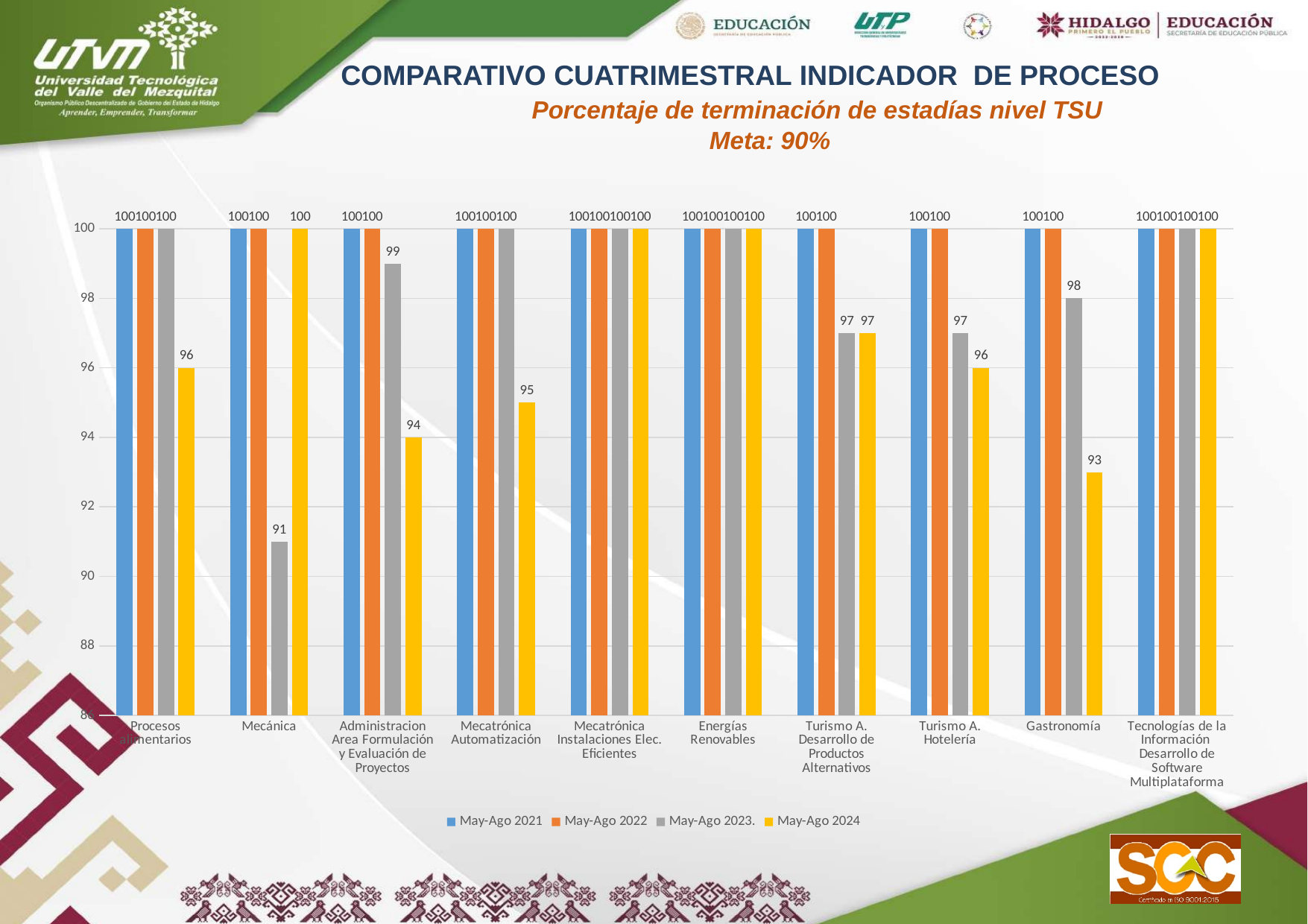
Which category has the lowest May-Ago 2024 value? Gastronomía Which category has the lowest May-Ago 2023 value? Mecánica How many categories (programs) are shown on the x axis? 10 Which is larger for Turismo A. Hotelería: the May-Ago 2023 value or the May-Ago 2024 value? May-Ago 2023 What target (Meta) is stated in the chart's subtitle? 90% What is the May-Ago 2024 value for Gastronomía? 93 What is the May-Ago 2024 value for Procesos alimentarios? 96 What is the difference between the May-Ago 2023 and May-Ago 2024 values for Gastronomía? 5 What kind of chart is shown on the slide? bar chart What is the May-Ago 2023 value for Administracion Area Formulación y Evaluación de Proyectos? 99 What is the May-Ago 2023 value for Mecánica? 91 How many series does the legend list? 4